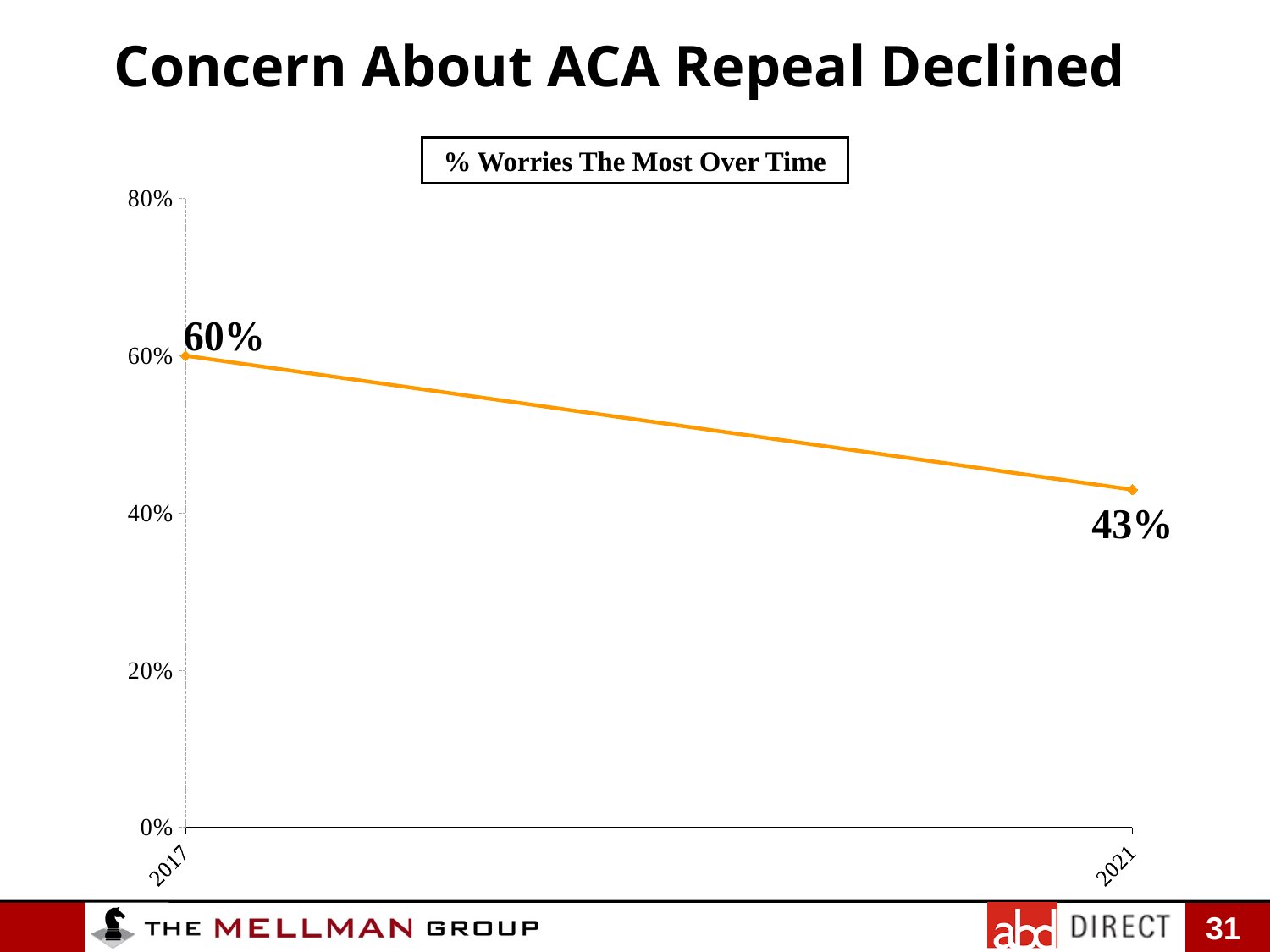
Which is larger, the value for 2017 or the value for 2021? 2017 Do the values rise or fall from 2017 to 2021? fall What is the value for 2021? 43% Which year has the lowest value? 2021 Which year has the highest value? 2017 What kind of chart is shown on the slide? line chart How many data points are plotted on the chart? 2 Is the value for 2021 greater or less than 40%? greater What is the title of the chart? % Worries The Most Over Time Is the value for 2017 greater or less than 80%? less What is the value for 2017? 60% What is the difference between the 2017 value and the 2021 value? 17%